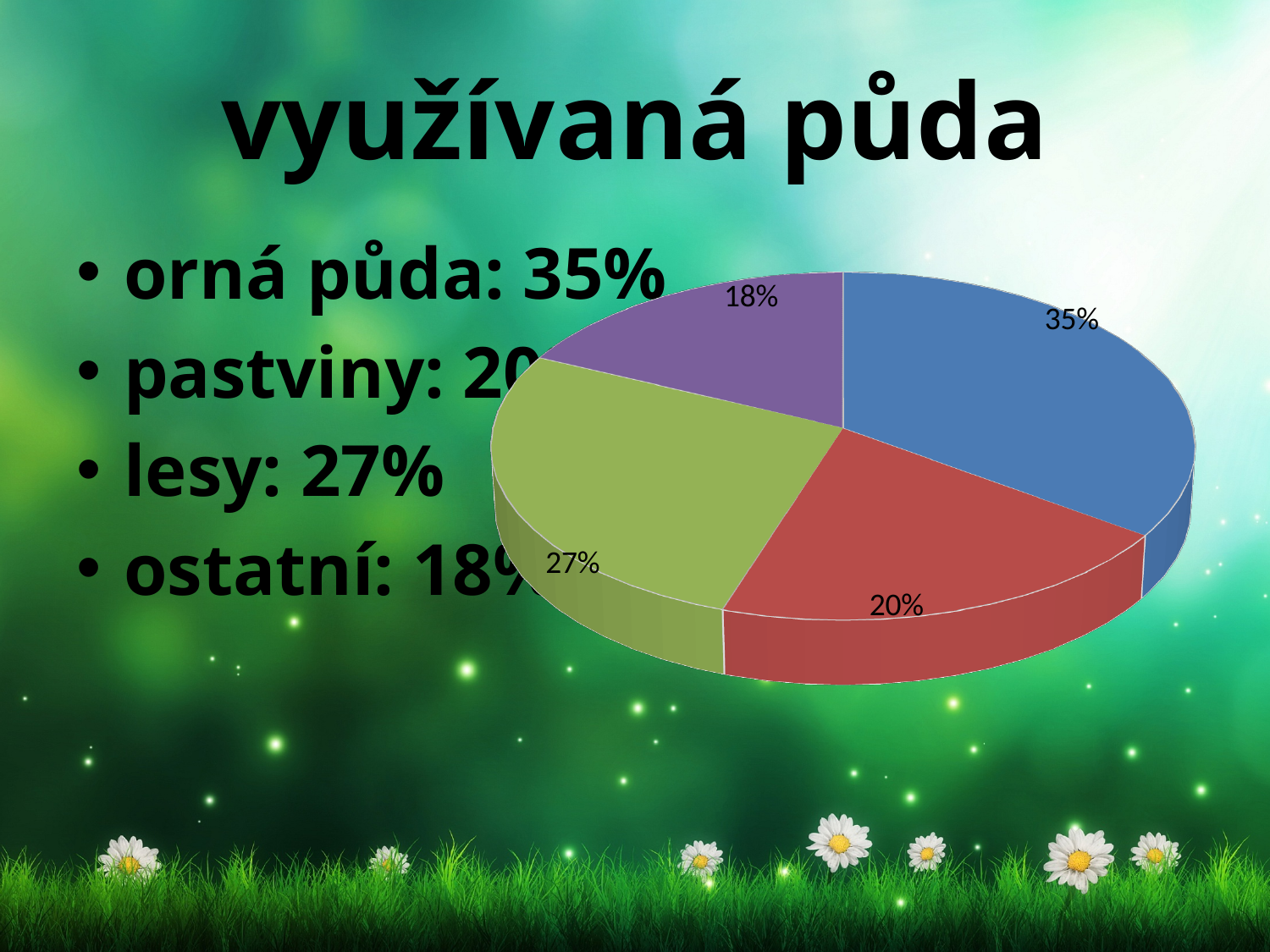
How many slices does the pie chart have? 4 Which slice is larger in the pie chart, the green slice or the red slice? green slice What is the smallest share shown in the pie chart? 18% What percentage is shown on the purple slice of the pie chart? 18% What percentage is shown on the red slice of the pie chart? 20% What kind of chart is shown on the slide? pie chart What is the title of the slide containing the pie chart? využívaná půda What is the largest share shown in the pie chart? 35% According to the slide, which land-use category corresponds to the 27% slice? lesy What percentage is shown on the blue slice of the pie chart? 35% What percentage is shown on the green slice of the pie chart? 27% What is the difference between the largest slice (35%) and the smallest slice (18%) in the pie chart? 17%